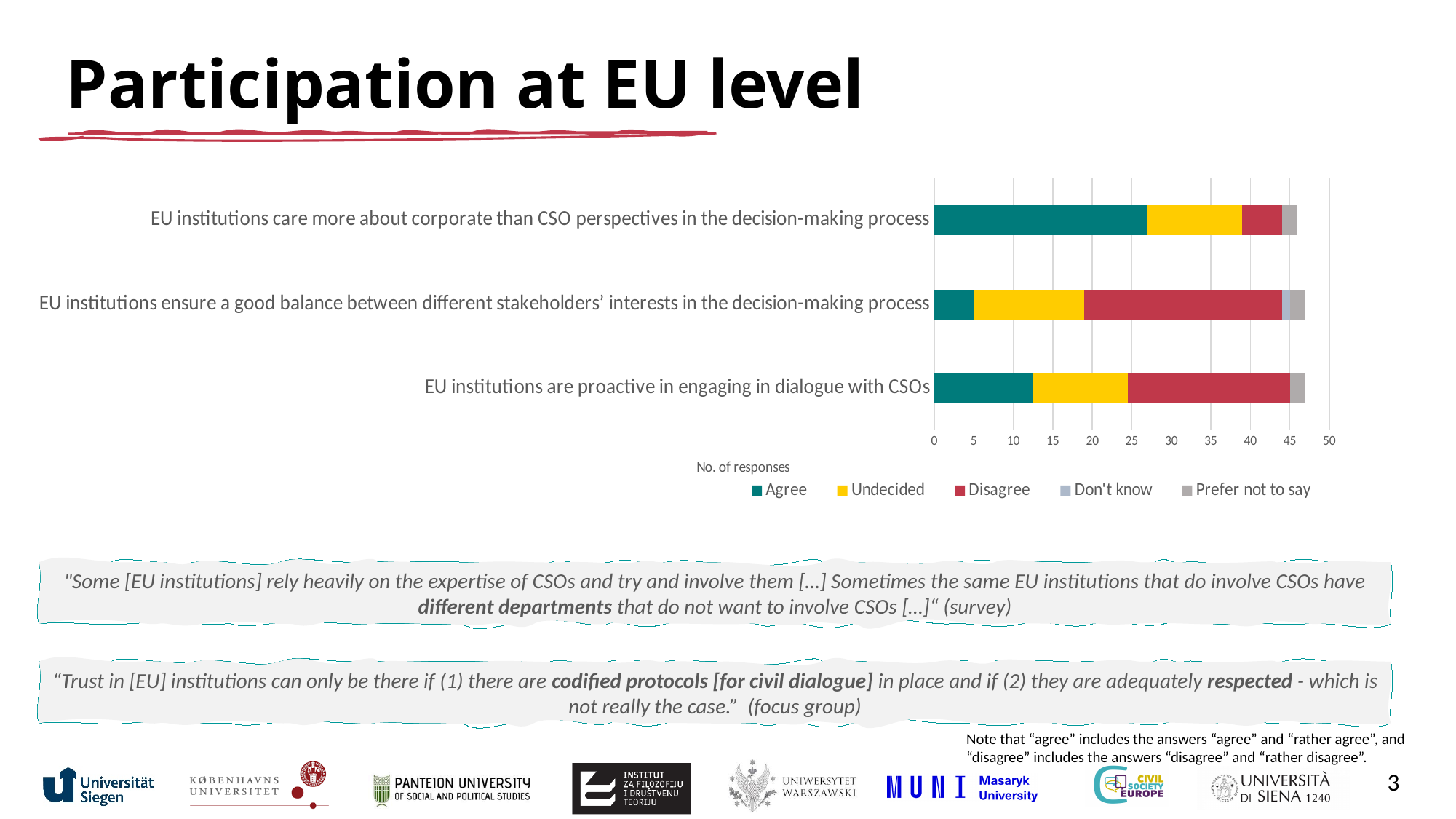
What is the label of the horizontal axis of the chart? No. of responses What kind of chart is shown on the slide? Stacked bar chart Is the 'Agree' value for 'EU institutions are proactive in engaging in dialogue with CSOs' greater or less than 10? greater How many series does the chart legend list? 5 Which statement has the largest 'Agree' segment? EU institutions care more about corporate than CSO perspectives in the decision-making process How many statements (categories) are plotted in the chart? 3 Which is larger: the 'Disagree' segment for 'EU institutions ensure a good balance between different stakeholders' interests' or the 'Disagree' segment for 'EU institutions care more about corporate than CSO perspectives'? EU institutions ensure a good balance between different stakeholders' interests in the decision-making process Which statement has the smallest 'Agree' segment? EU institutions ensure a good balance between different stakeholders' interests in the decision-making process Which statement has the largest 'Disagree' segment? EU institutions ensure a good balance between different stakeholders' interests in the decision-making process Is the 'Agree' value for 'EU institutions ensure a good balance between different stakeholders' interests in the decision-making process' greater or less than 10? less Is the 'Agree' value for 'EU institutions care more about corporate than CSO perspectives in the decision-making process' greater or less than 20? greater Which colour represents 'Disagree' in the chart legend? Red